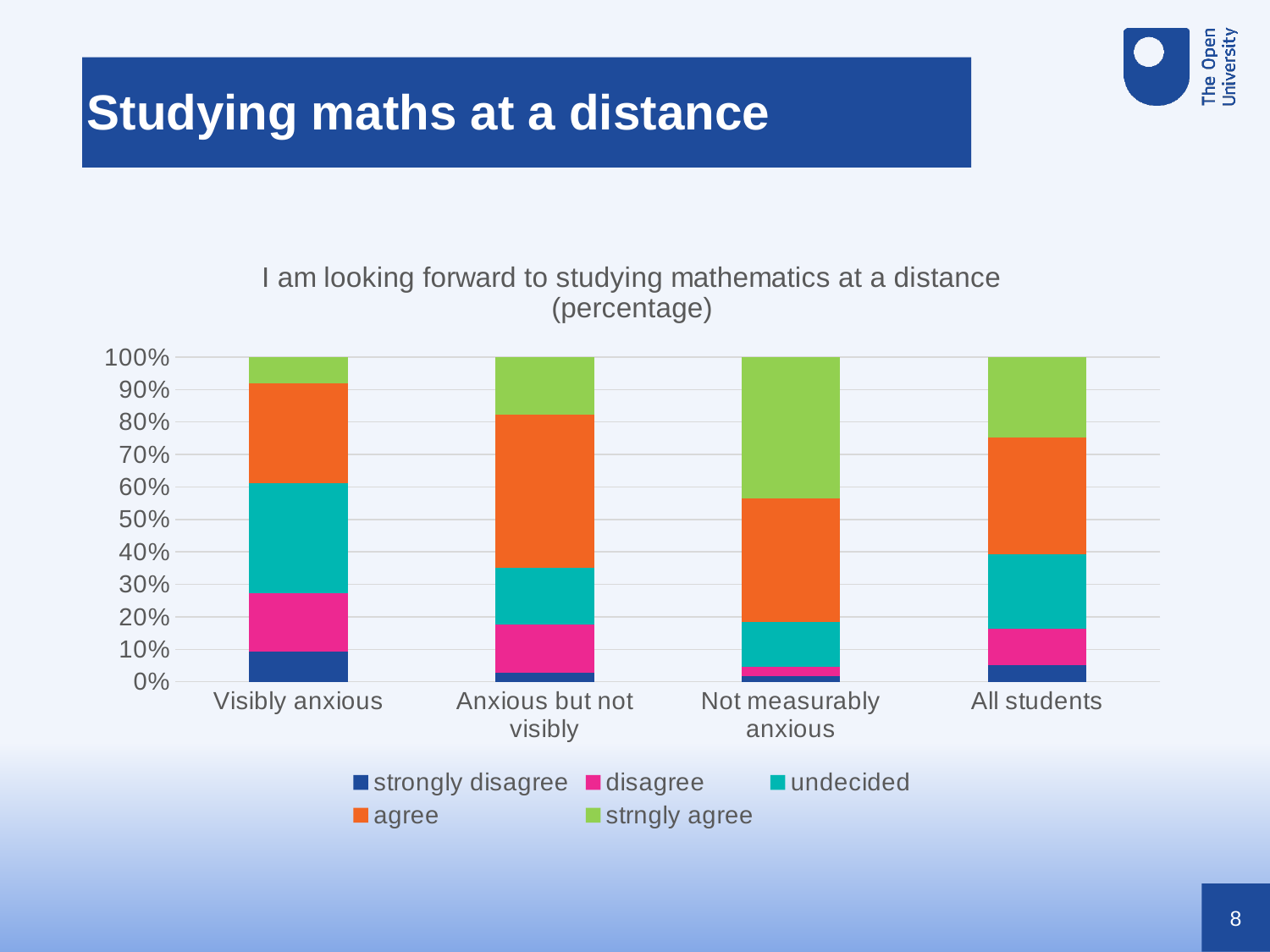
Is the 'strongly disagree' segment for All students greater or less than 10%? less Which series is shown in orange in the chart? agree Is the 'strngly agree' segment for Not measurably anxious greater or less than 30%? greater Which category has the largest 'strngly agree' segment? Not measurably anxious Which is larger: the 'disagree' segment for Visibly anxious or the 'disagree' segment for Not measurably anxious? Visibly anxious How many series does the chart's legend list? 5 What is the title of the chart? I am looking forward to studying mathematics at a distance (percentage) What is the total of the stacked bar for All students? 100% How many categories are shown along the x axis of the chart? 4 Which category has the largest 'undecided' segment? Visibly anxious Which category has the smallest 'strngly agree' segment? Visibly anxious What kind of chart is shown on the slide? stacked bar chart